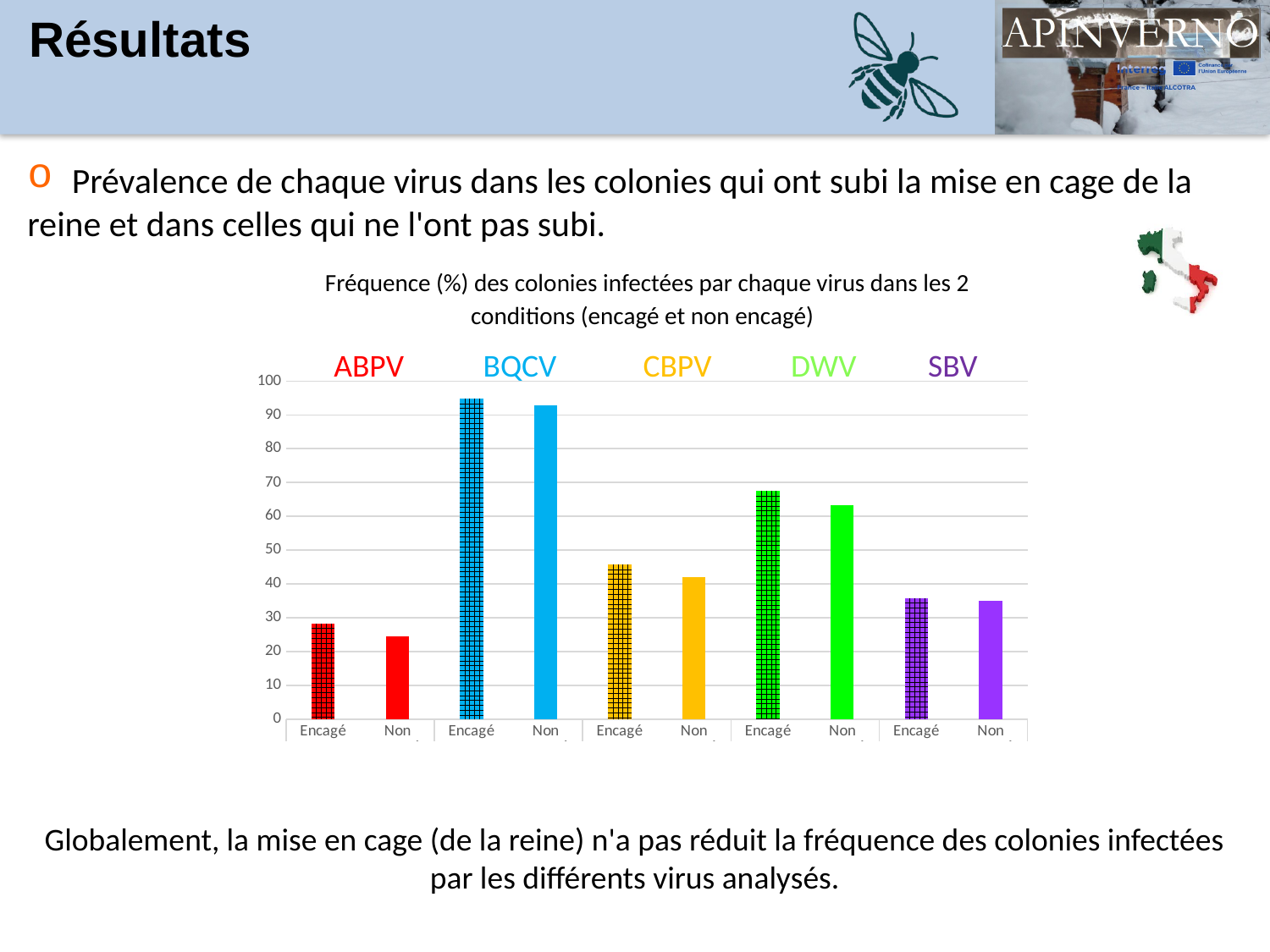
How many bars are plotted in the chart? 10 Is the value for SBV Encagé greater or less than 30? greater How many viruses are labelled above the chart? 5 What is the title of the chart? Fréquence (%) des colonies infectées par chaque virus dans les 2 conditions (encagé et non encagé) Which virus has the highest frequency of infected colonies in the chart? BQCV Is the value for DWV Encagé greater or less than 60? greater Which virus has the lowest frequency of infected colonies in the chart? ABPV What kind of chart is shown on the slide? bar chart Is the value for BQCV Encagé greater or less than 90? greater For DWV, which is larger: the Encagé bar or the Non bar? Encagé